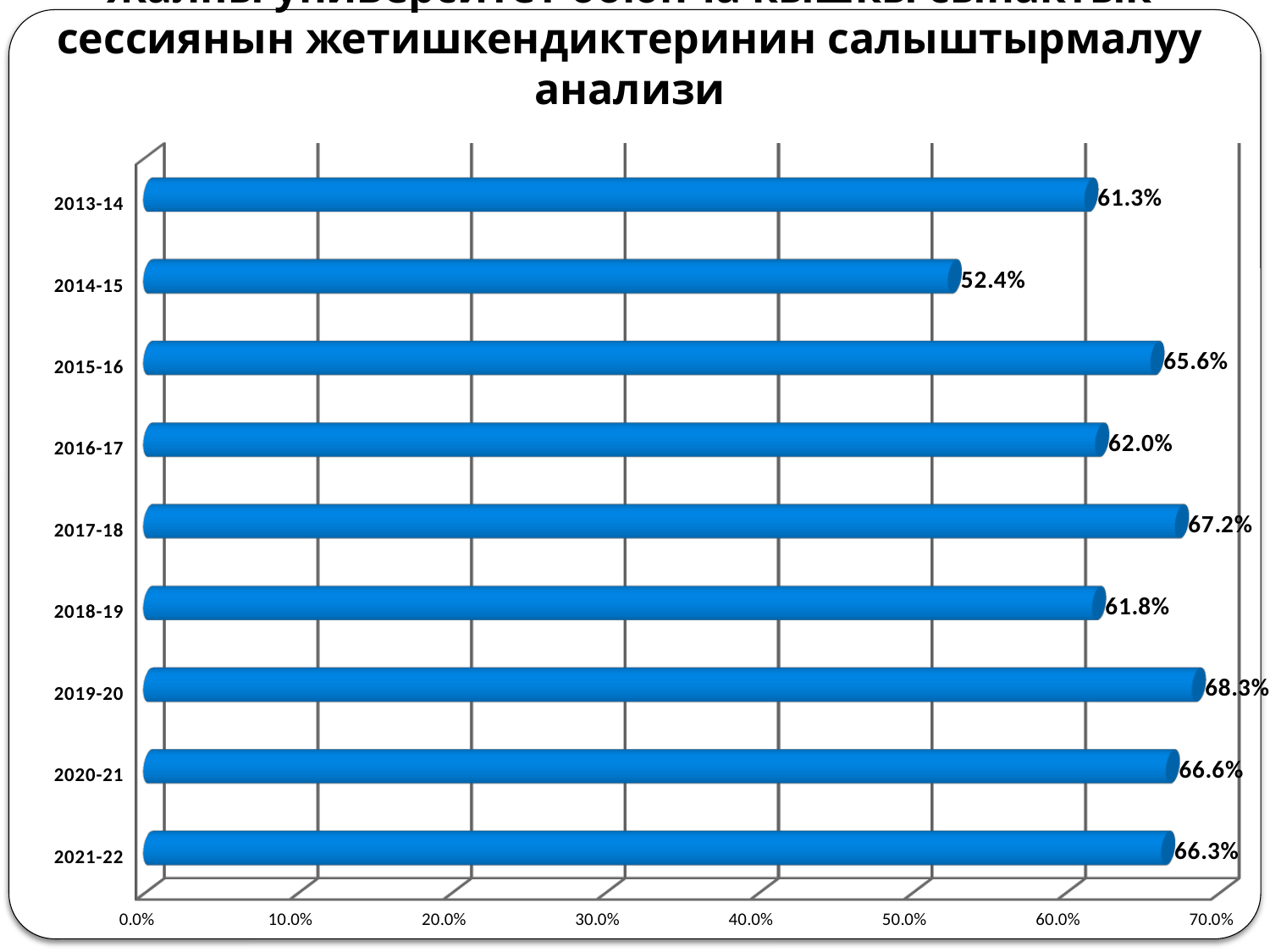
How many academic years are shown on the chart? 9 Which academic year has the highest value? 2019-20 What kind of chart is shown on the slide? bar chart What is the value for 2021-22? 66.3% What is the maximum value shown on the horizontal axis? 70.0% What is the difference between the values for 2020-21 and 2021-22? 0.3% Is the value for 2013-14 greater or less than 60.0%? greater Which is larger, the value for 2015-16 or the value for 2016-17? 2015-16 What is the value for 2019-20? 68.3% Which academic year has the lowest value? 2014-15 What is the value for 2014-15? 52.4% What is the difference between the values for 2019-20 and 2014-15? 15.9%